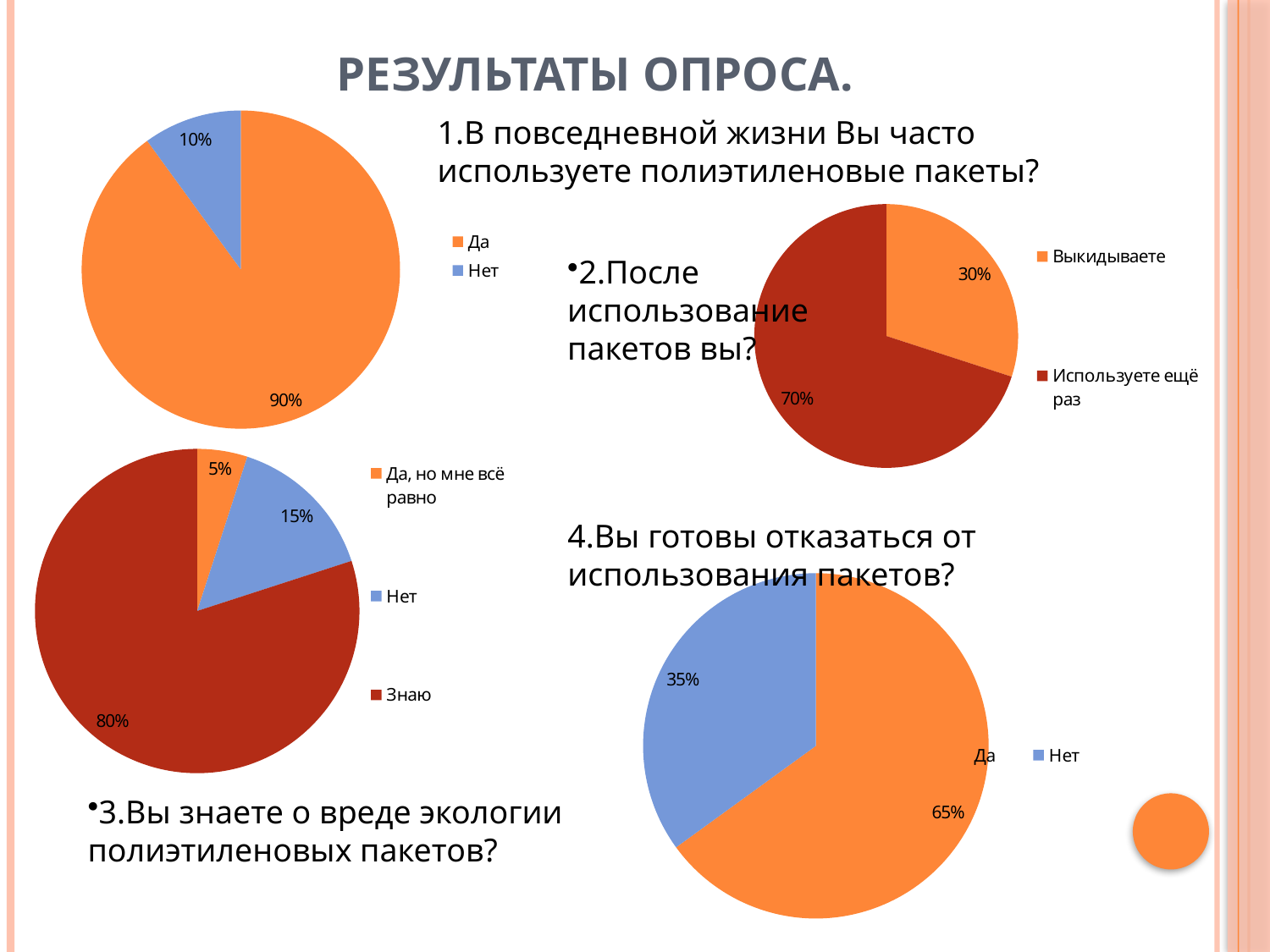
What type of chart is used for all four charts on the slide? Pie chart In the bottom-right pie chart (question 4), what is the difference in percentage points between the "Да" and "Нет" shares? 30 In the top-right pie chart (question 2), which is larger: the share for "Выкидываете" or for "Используете ещё раз"? Используете ещё раз In the bottom-left pie chart (question 3), how many slices does the pie have? 3 In the bottom-right pie chart (question 4, about being ready to give up plastic bags), what share of respondents answered "Нет"? 35% In the bottom-left pie chart (question 3), which answer has the smallest share? Да, но мне всё равно In the top-right pie chart (question 2, what you do with bags after use), what share of respondents chose "Используете ещё раз"? 70% In the top-left pie chart (question 1, about often using plastic bags), what share of respondents answered "Да"? 90% In the top-right pie chart (question 2), what share of respondents chose "Выкидываете"? 30% In the bottom-left pie chart (question 3, about knowing the environmental harm of plastic bags), which answer has the largest share? Знаю In the top-left pie chart (question 1), what share of respondents answered "Нет"? 10% In the bottom-left pie chart (question 3), what share of respondents answered "Нет"? 15%